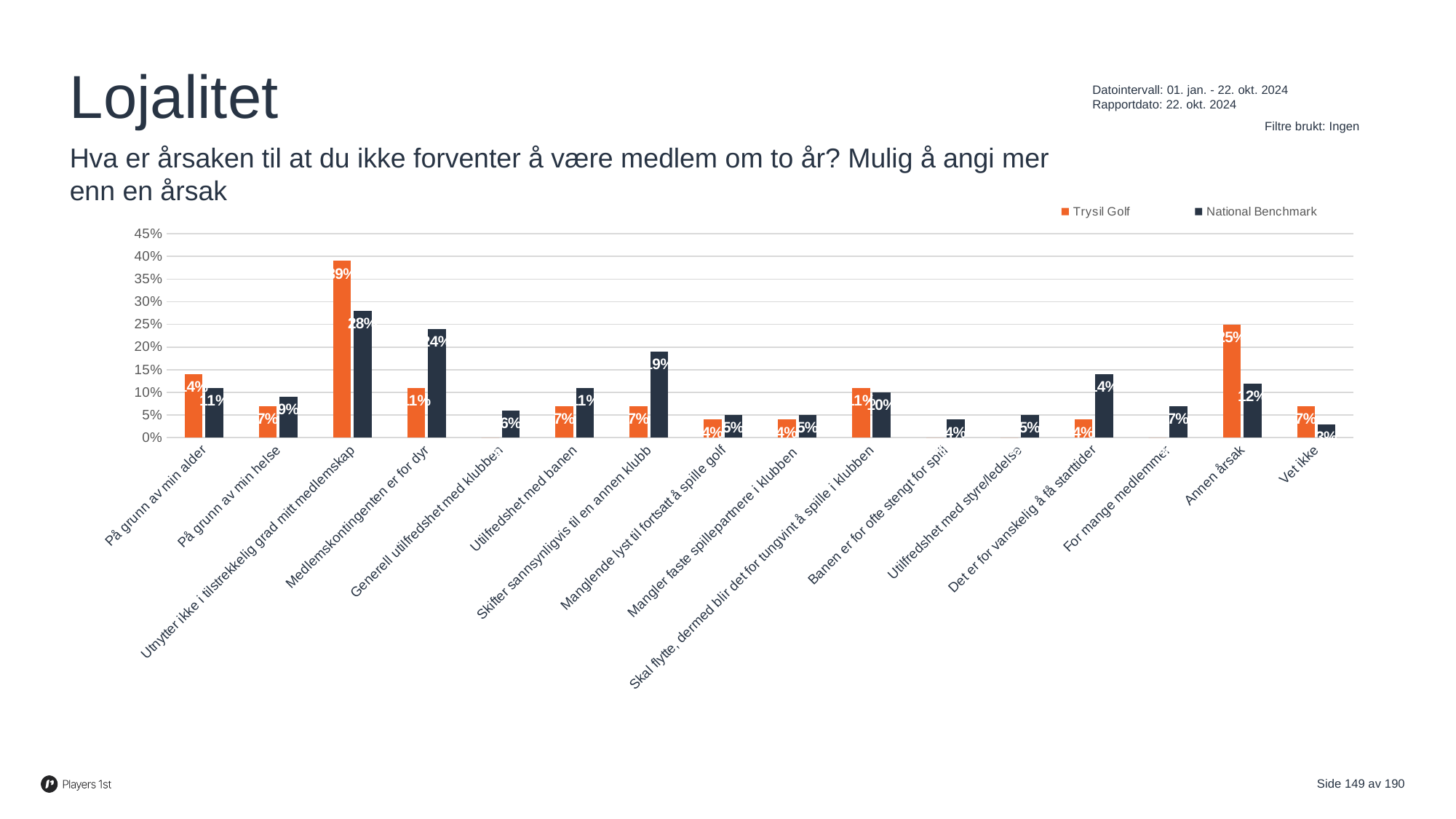
Is the National Benchmark value for 'Det er for vanskelig å få starttider' greater or less than 10%? greater What type of chart is shown on the slide? bar chart For 'Skifter sannsynligvis til en annen klubb', which series has the larger value, Trysil Golf or National Benchmark? National Benchmark What is the Trysil Golf value for 'Annen årsak'? 25% Which colour represents Trysil Golf in the legend? orange What is the difference between the Trysil Golf and National Benchmark values for 'Utnytter ikke i tilstrekkelig grad mitt medlemskap'? 11% What is the National Benchmark value for 'Utnytter ikke i tilstrekkelig grad mitt medlemskap'? 28% How many series does the legend list? 2 Which category has the lowest National Benchmark value? Vet ikke What is the Trysil Golf value for 'Utnytter ikke i tilstrekkelig grad mitt medlemskap'? 39% What is the National Benchmark value for 'Medlemskontingenten er for dyr'? 24% Which category has the highest Trysil Golf value? Utnytter ikke i tilstrekkelig grad mitt medlemskap